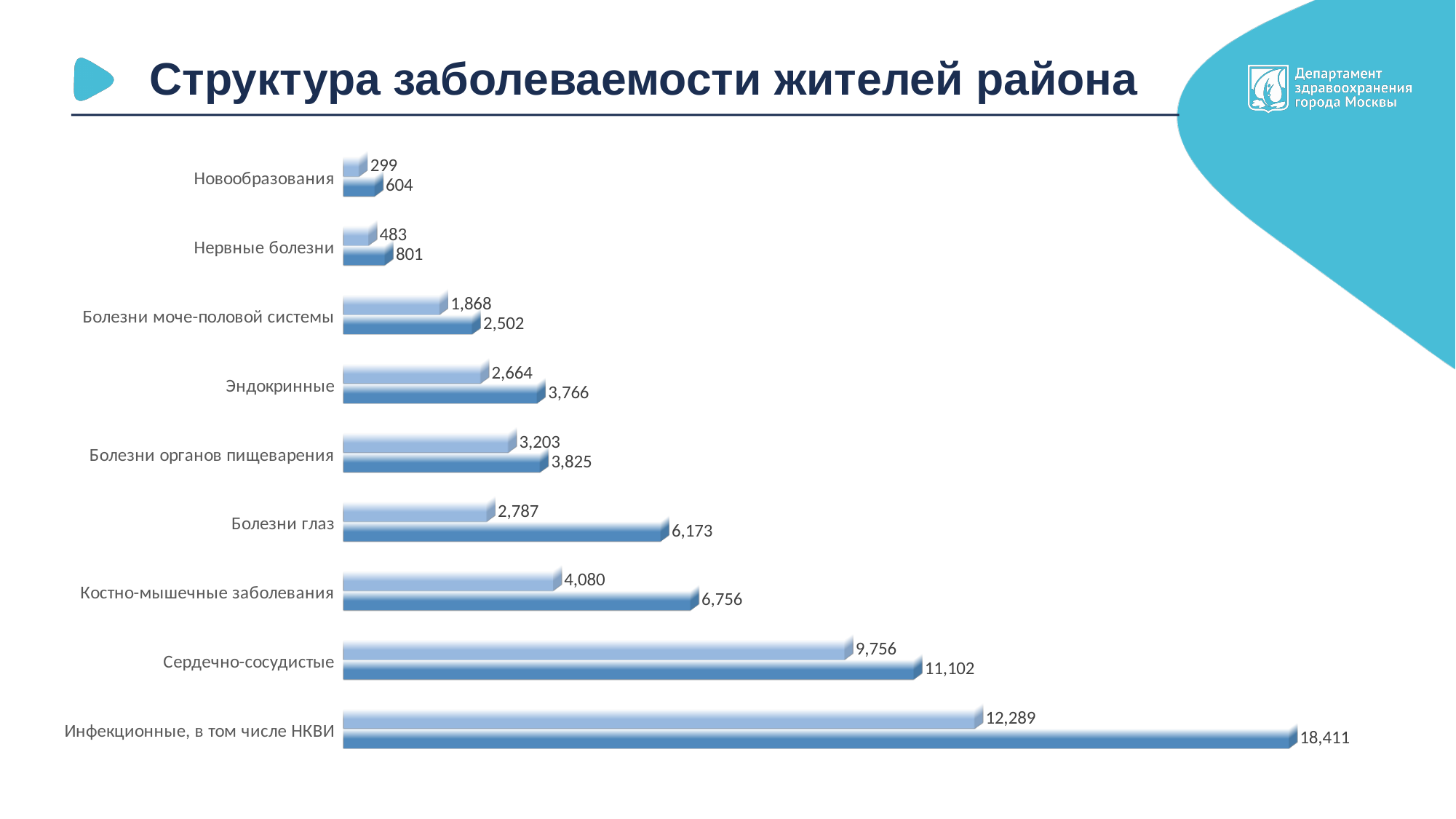
How many categories are shown on the chart? 9 Which category has the lowest value for the lighter blue bars? Новообразования Which is larger: the darker blue bar for Эндокринные or the darker blue bar for Болезни органов пищеварения? Болезни органов пищеварения What is the value of the darker blue bar for Инфекционные, в том числе НКВИ? 18,411 What is the value of the lighter blue bar for Сердечно-сосудистые? 9,756 What is the value of the lighter blue bar for Новообразования? 299 Which category has the highest value for the darker blue bars? Инфекционные, в том числе НКВИ What is the difference between the darker blue and lighter blue bars for Инфекционные, в том числе НКВИ? 6,122 What is the difference between the darker blue bars for Сердечно-сосудистые and Костно-мышечные заболевания? 4,346 What type of chart is shown on the slide? bar chart What is the value of the darker blue bar for Болезни глаз? 6,173 What is the title of the chart on the slide? Структура заболеваемости жителей района